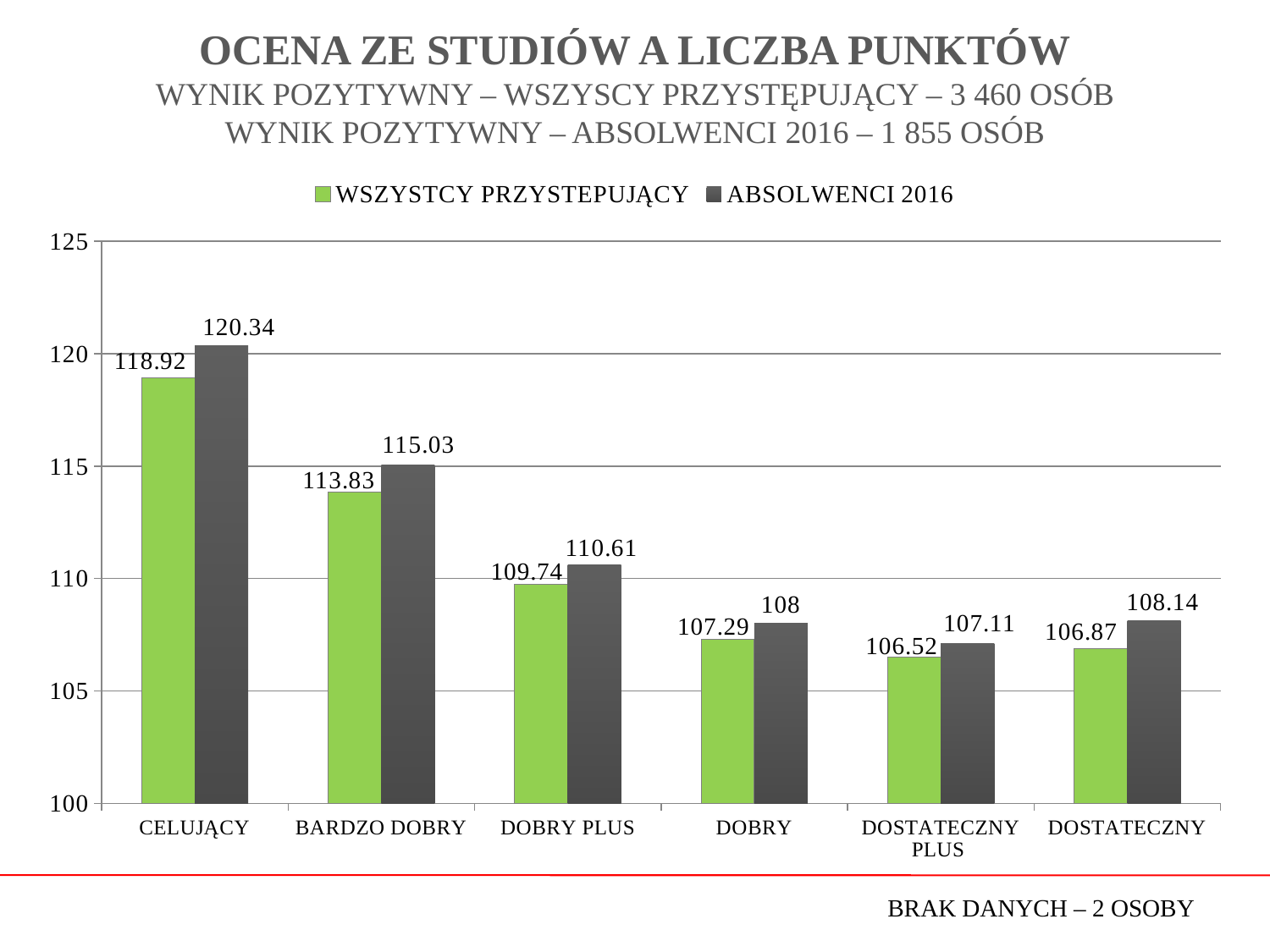
Which is larger in the DOSTATECZNY category: WSZYSTCY PRZYSTEPUJĄCY or ABSOLWENCI 2016? ABSOLWENCI 2016 Is the value for WSZYSTCY PRZYSTEPUJĄCY in the BARDZO DOBRY category greater or less than 115? less How many categories are shown on the x axis? 6 What is the value for ABSOLWENCI 2016 in the BARDZO DOBRY category? 115.03 What is the value for WSZYSTCY PRZYSTEPUJĄCY in the CELUJĄCY category? 118.92 What is the value for ABSOLWENCI 2016 in the DOBRY category? 108 Which category has the lowest value for WSZYSTCY PRZYSTEPUJĄCY? DOSTATECZNY PLUS Do the ABSOLWENCI 2016 values rise or fall from CELUJĄCY to DOBRY? fall Which category has the highest value for ABSOLWENCI 2016? CELUJĄCY What is the difference between the ABSOLWENCI 2016 and WSZYSTCY PRZYSTEPUJĄCY values in the DOBRY PLUS category? 0.87 How many series does the legend list? 2 What kind of chart is shown on the slide? bar chart